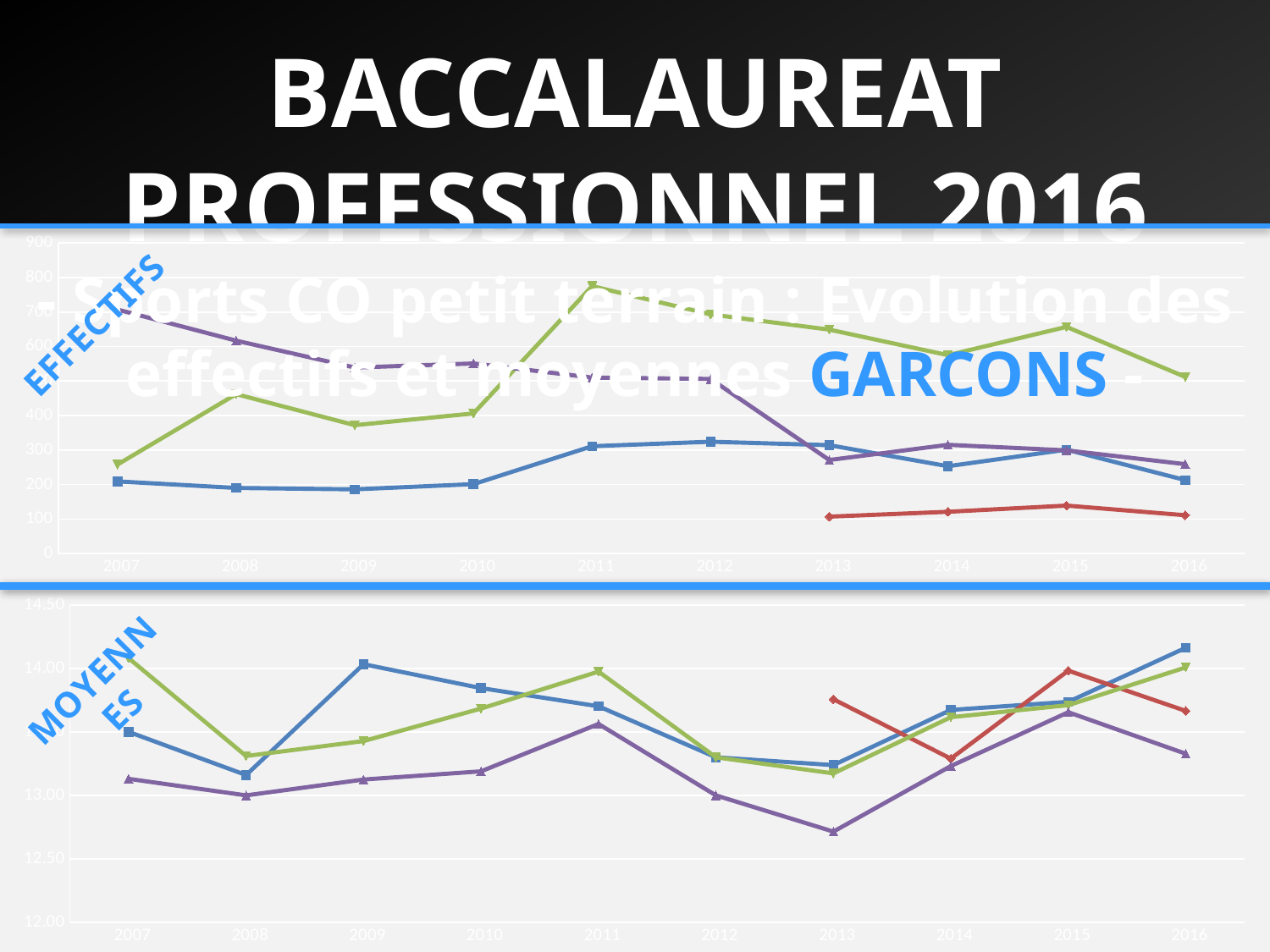
In the top chart (EFFECTIFS), in which year does the red line first appear? 2013 In the bottom chart (MOYENNES), is the value of the blue line in 2016 greater or less than 14.00? greater In the bottom chart (MOYENNES), in which year does the purple line reach its lowest value? 2013 How many years are shown on the x axis of the top chart (EFFECTIFS)? 10 In the bottom chart (MOYENNES), is the value of the purple line in 2013 greater or less than 13.00? less In the top chart (EFFECTIFS), is the value of the red line in 2013 greater or less than 200? less How many charts are shown on the slide? 2 What kind of chart is the top chart labelled EFFECTIFS? line chart In the top chart (EFFECTIFS), does the purple line overall rise or fall from 2007 to 2016? fall In the top chart (EFFECTIFS), in which year does the green line reach its highest value? 2011